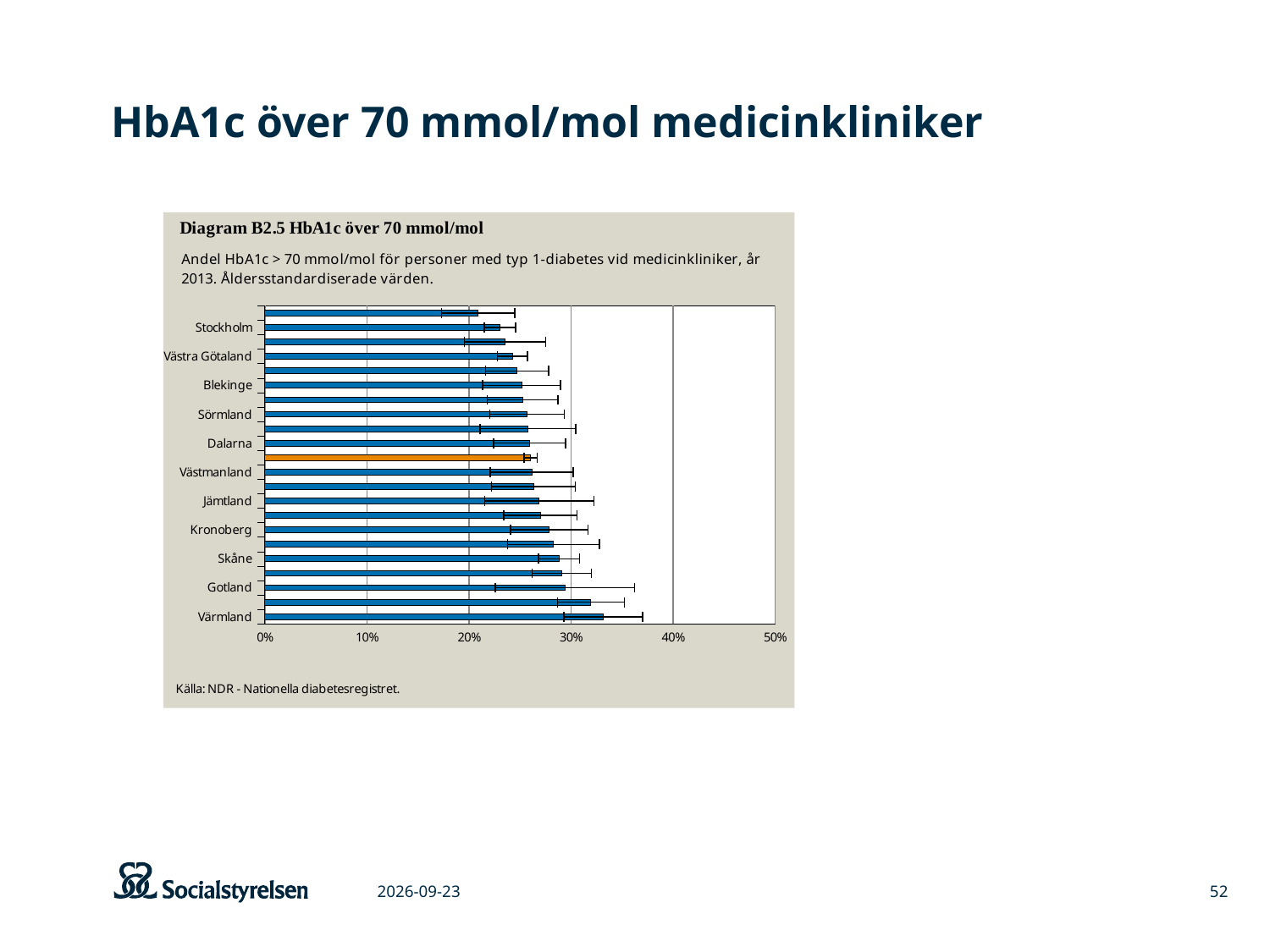
Do the bar values increase or decrease going from the top of the chart to the bottom? increase Which has the larger value, Värmland or Stockholm? Värmland Is the value for Stockholm greater or less than 20%? greater What is the highest value shown on the x axis? 50% Is the value for Stockholm greater or less than 30%? less Which labeled region has the longest bar? Värmland Is the value for Värmland greater or less than 40%? less What is the title printed inside the chart box? Diagram B2.5 HbA1c över 70 mmol/mol What kind of chart is shown on the slide? bar chart Which has the larger value, Gotland or Västra Götaland? Gotland